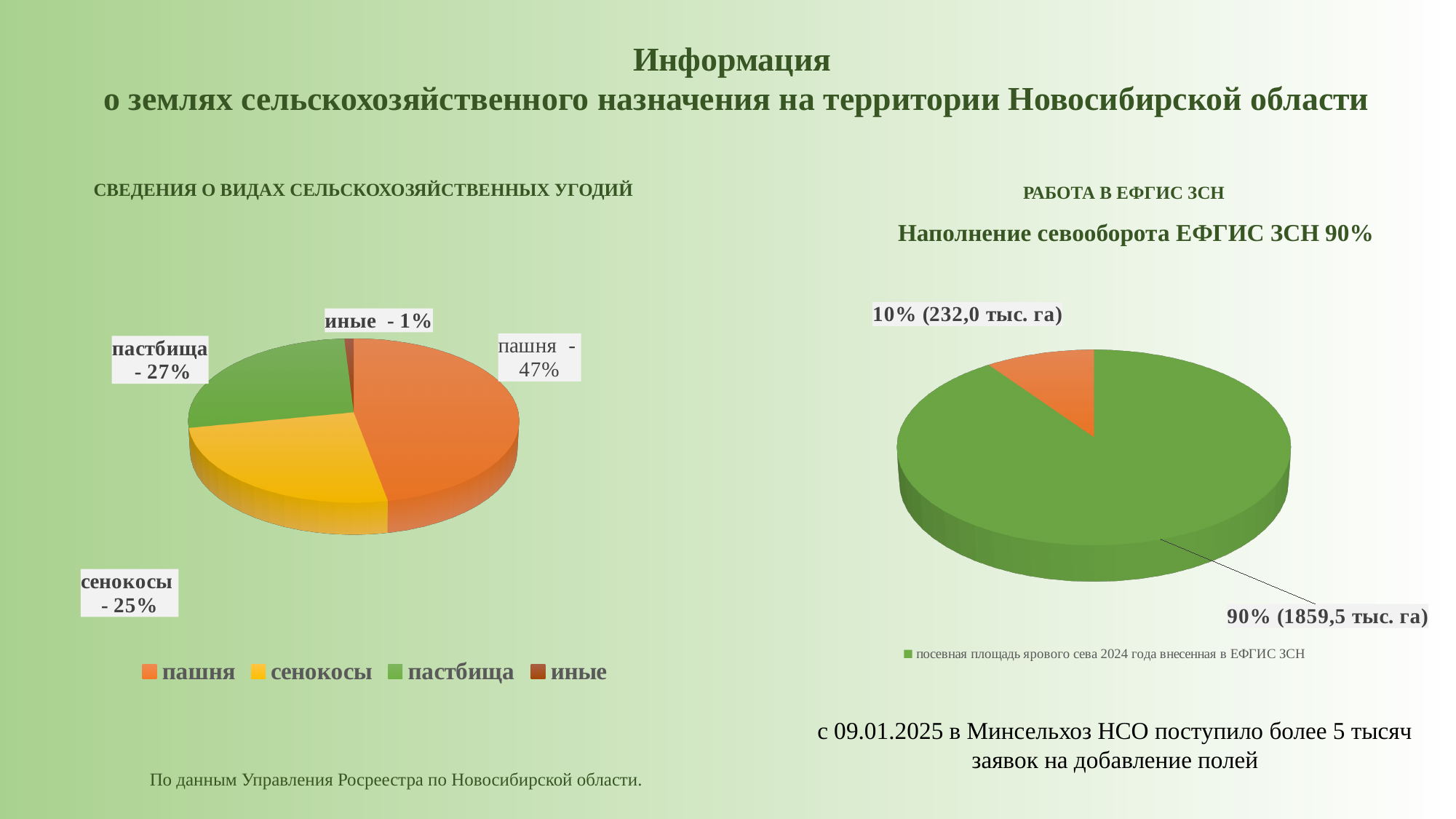
On the left chart (СВЕДЕНИЯ О ВИДАХ СЕЛЬСКОХОЗЯЙСТВЕННЫХ УГОДИЙ), which category has the smallest share? иные On the left chart (СВЕДЕНИЯ О ВИДАХ СЕЛЬСКОХОЗЯЙСТВЕННЫХ УГОДИЙ), what is the difference in percentage points between пашня and сенокосы? 22 On the left chart (СВЕДЕНИЯ О ВИДАХ СЕЛЬСКОХОЗЯЙСТВЕННЫХ УГОДИЙ), what colour is the сенокосы slice? yellow On the left chart (СВЕДЕНИЯ О ВИДАХ СЕЛЬСКОХОЗЯЙСТВЕННЫХ УГОДИЙ), what share does пашня have? 47% What kind of chart is the left chart (СВЕДЕНИЯ О ВИДАХ СЕЛЬСКОХОЗЯЙСТВЕННЫХ УГОДИЙ)? pie chart On the right chart (Наполнение севооборота ЕФГИС ЗСН 90%), what area in тыс. га corresponds to the 10% slice? 232,0 тыс. га On the left chart (СВЕДЕНИЯ О ВИДАХ СЕЛЬСКОХОЗЯЙСТВЕННЫХ УГОДИЙ), which category has the largest share? пашня On the left chart (СВЕДЕНИЯ О ВИДАХ СЕЛЬСКОХОЗЯЙСТВЕННЫХ УГОДИЙ), what share does сенокосы have? 25% On the left chart (СВЕДЕНИЯ О ВИДАХ СЕЛЬСКОХОЗЯЙСТВЕННЫХ УГОДИЙ), which is larger: пастбища or сенокосы? пастбища How many categories does the left chart (СВЕДЕНИЯ О ВИДАХ СЕЛЬСКОХОЗЯЙСТВЕННЫХ УГОДИЙ) show? 4 On the left chart (СВЕДЕНИЯ О ВИДАХ СЕЛЬСКОХОЗЯЙСТВЕННЫХ УГОДИЙ), what share does пастбища have? 27% On the right chart (Наполнение севооборота ЕФГИС ЗСН 90%), what area in тыс. га corresponds to the 90% slice? 1859,5 тыс. га